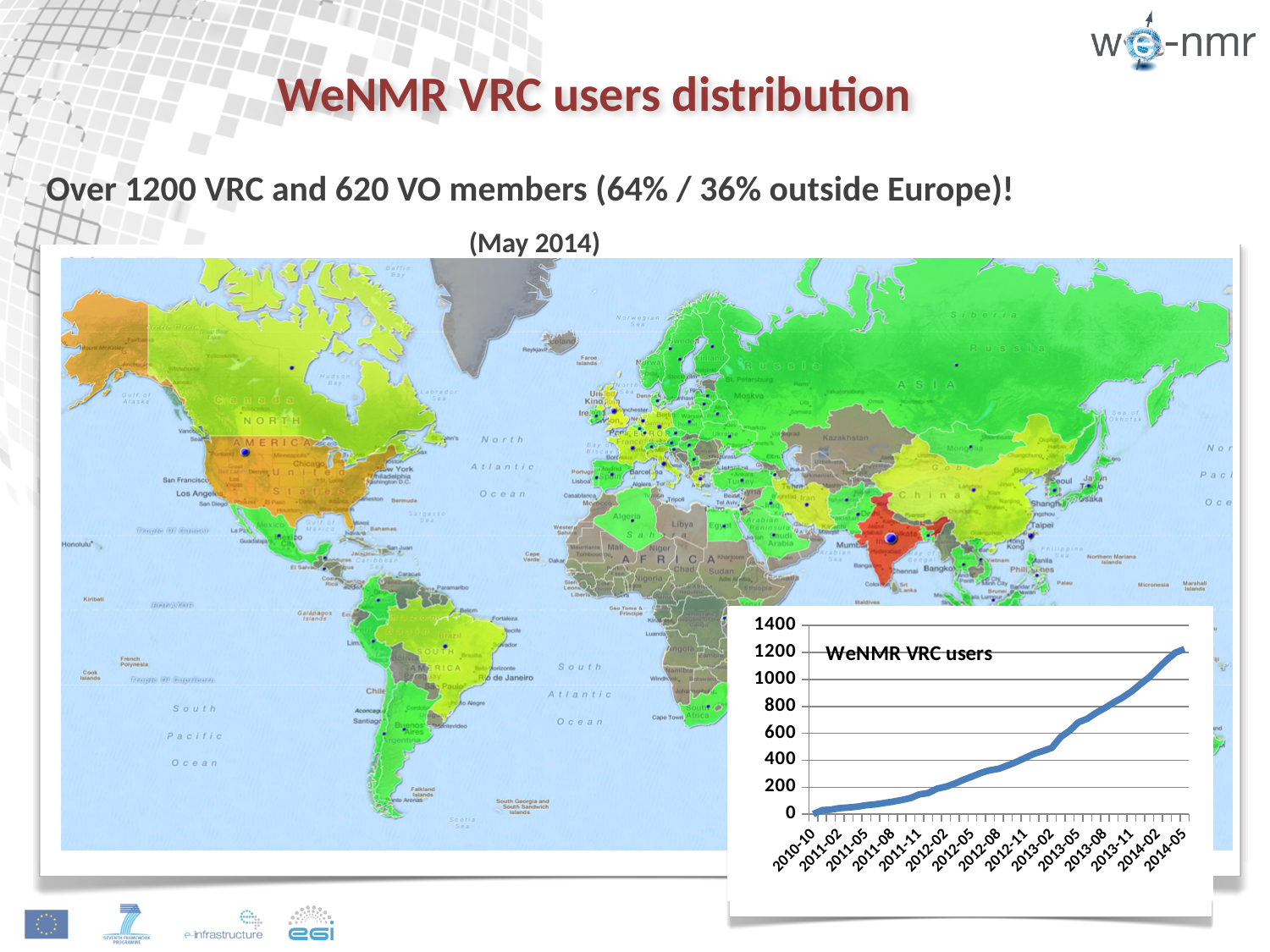
In the WeNMR VRC users chart, is the value for 2010-10 greater or less than 200? less In the WeNMR VRC users chart, is the value for 2013-05 greater or less than 400? greater In the WeNMR VRC users chart, is the value for 2014-02 larger or smaller than the value for 2013-02? larger In the WeNMR VRC users chart, do the values rise or fall from 2010-10 to 2014-05? rise In the WeNMR VRC users chart, which labelled date has the lowest value? 2010-10 What is the title of the line chart on the slide? WeNMR VRC users In the WeNMR VRC users chart, is the value for 2013-11 greater or less than 800? greater What kind of chart is shown in the bottom-right corner of the slide? line chart What is the highest value shown on the y axis of the WeNMR VRC users chart? 1400 In the WeNMR VRC users chart, which labelled date has the highest value? 2014-05